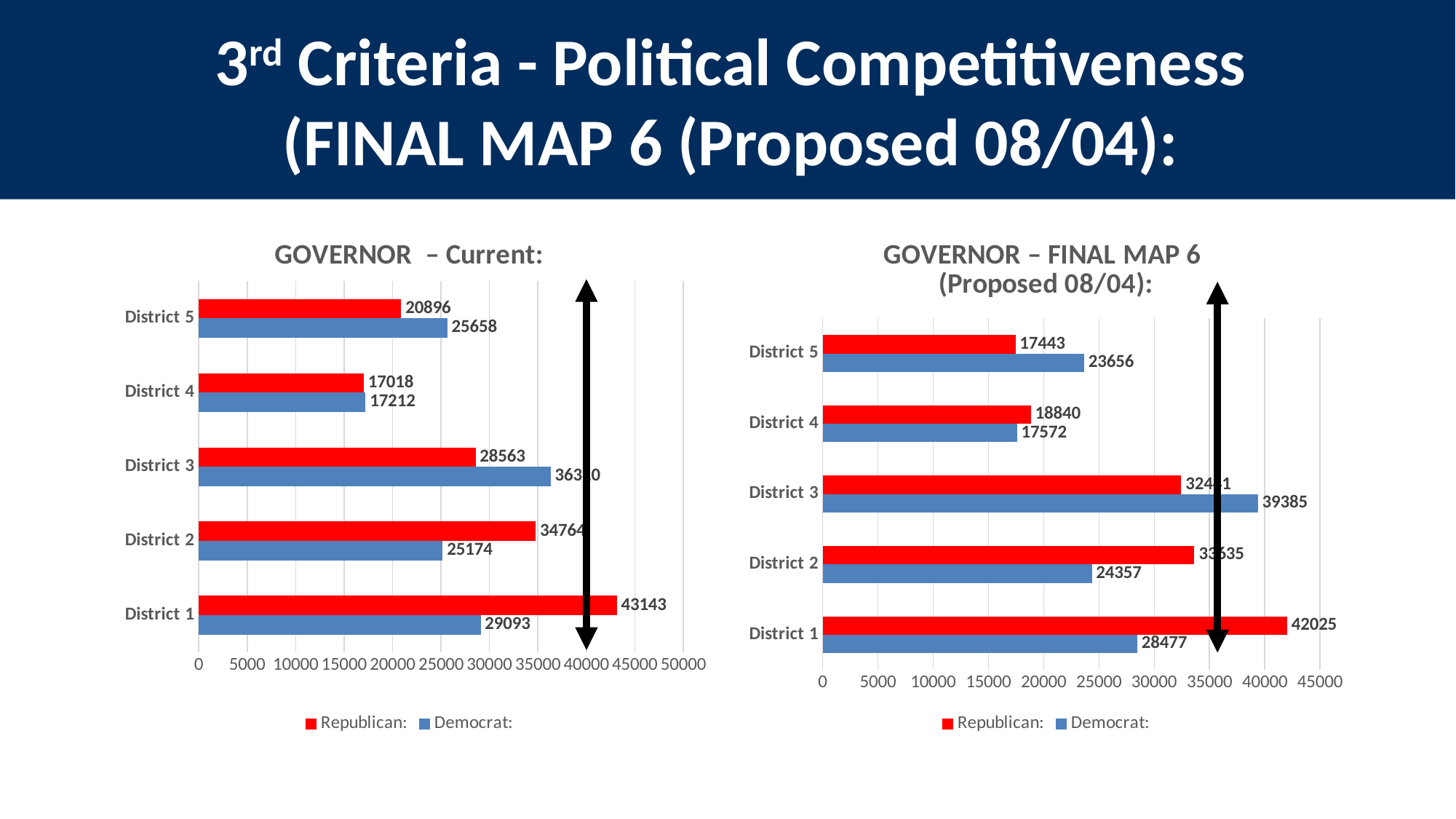
What type of chart is the GOVERNOR – Current chart? Bar chart In the GOVERNOR – FINAL MAP 6 chart, what is the difference between the Democrat and Republican values for District 5? 6213 In the GOVERNOR – Current chart, what is the difference between the Republican and Democrat values for District 1? 14050 In the GOVERNOR – FINAL MAP 6 chart, is the Republican value for District 3 greater or less than 30000? greater In the GOVERNOR – FINAL MAP 6 chart, which district has the lowest Democrat value? District 4 In the GOVERNOR – Current chart, which is larger for District 2, the Republican value or the Democrat value? Republican In the GOVERNOR – Current chart, what is the Democrat value for District 5? 25658 How many districts are shown in the GOVERNOR – FINAL MAP 6 chart? 5 In the GOVERNOR – Current chart, which district has the highest Republican value? District 1 In the GOVERNOR – Current chart, what is the Republican value for District 1? 43143 In the GOVERNOR – FINAL MAP 6 chart, what is the Democrat value for District 3? 39385 In the GOVERNOR – FINAL MAP 6 chart, what is the Republican value for District 4? 18840